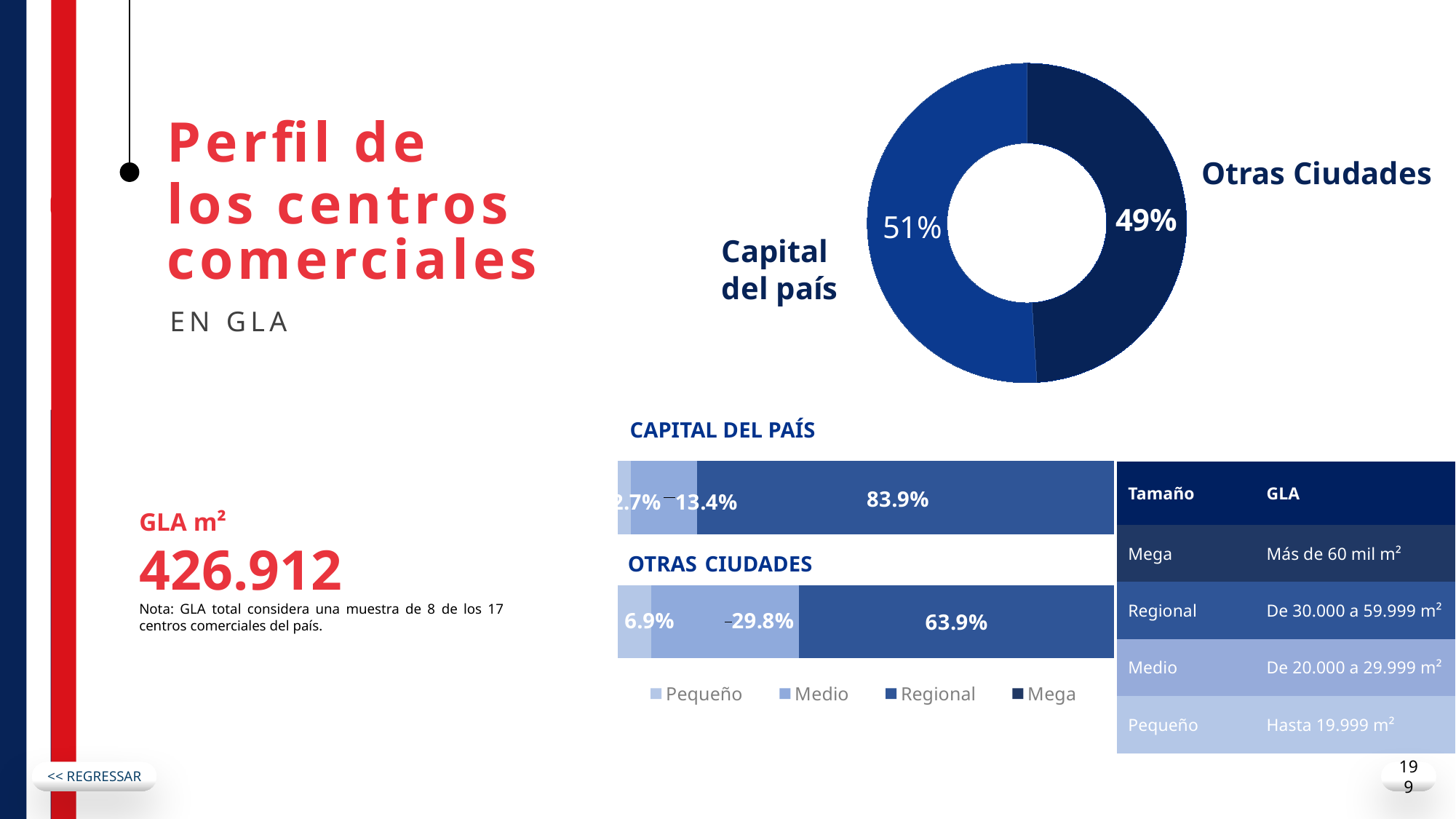
In the donut chart, which segment is larger, Capital del país or Otras Ciudades? Capital del país In the OTRAS CIUDADES stacked bar, what is the value of the Regional segment? 63.9% In the OTRAS CIUDADES stacked bar, what is the value of the Medio segment? 29.8% What type of chart is the chart at the top right showing Capital del país and Otras Ciudades? Donut (pie) chart In the CAPITAL DEL PAÍS stacked bar, what is the value of the Regional segment? 83.9% In the CAPITAL DEL PAÍS stacked bar, what is the value of the Medio segment? 13.4% How many series does the legend below the stacked bar charts list? 4 In the OTRAS CIUDADES stacked bar, which segment is the largest? Regional In the donut chart, what share is labelled for Capital del país? 51% In the OTRAS CIUDADES stacked bar, what is the value of the Pequeño segment? 6.9% What is the difference between the Regional segment in CAPITAL DEL PAÍS and the Regional segment in OTRAS CIUDADES? 20.0% In the donut chart, what share is labelled for Otras Ciudades? 49%